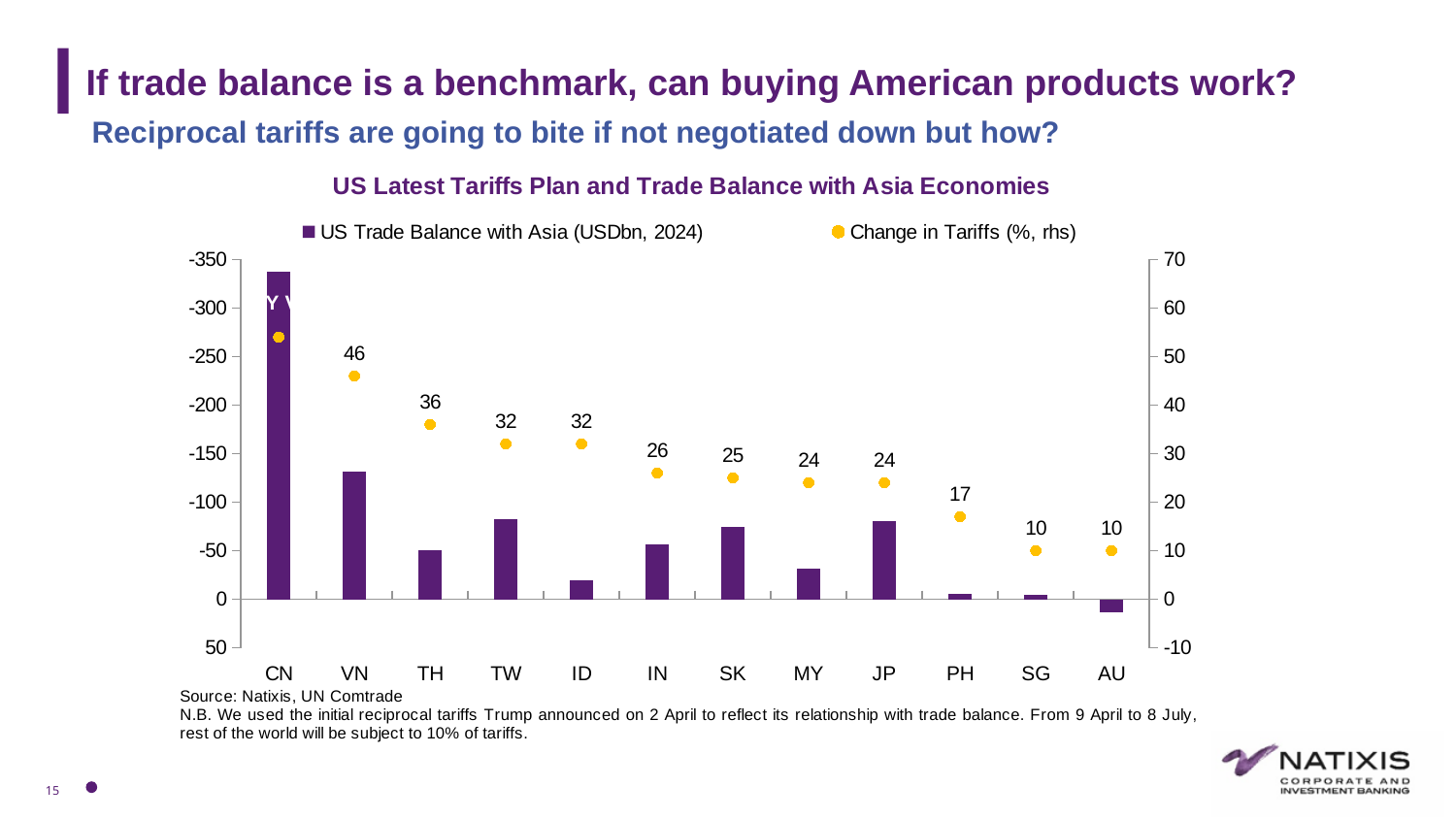
How many series does the legend list? 2 Which economy has the largest US trade deficit bar, CN or VN? CN Which economy has the highest Change in Tariffs (%)? CN What is the title of the chart? US Latest Tariffs Plan and Trade Balance with Asia Economies Which has a larger Change in Tariffs, IN or JP? IN How many economies are shown on the x axis? 12 What is the Change in Tariffs (%) for SK? 25 What is the Change in Tariffs (%) for TH? 36 What is the difference between the Change in Tariffs for VN and TH? 10 What is the Change in Tariffs (%) for VN? 46 Do the Change in Tariffs values generally rise or fall from left to right across the x axis? fall What is the Change in Tariffs (%) for PH? 17